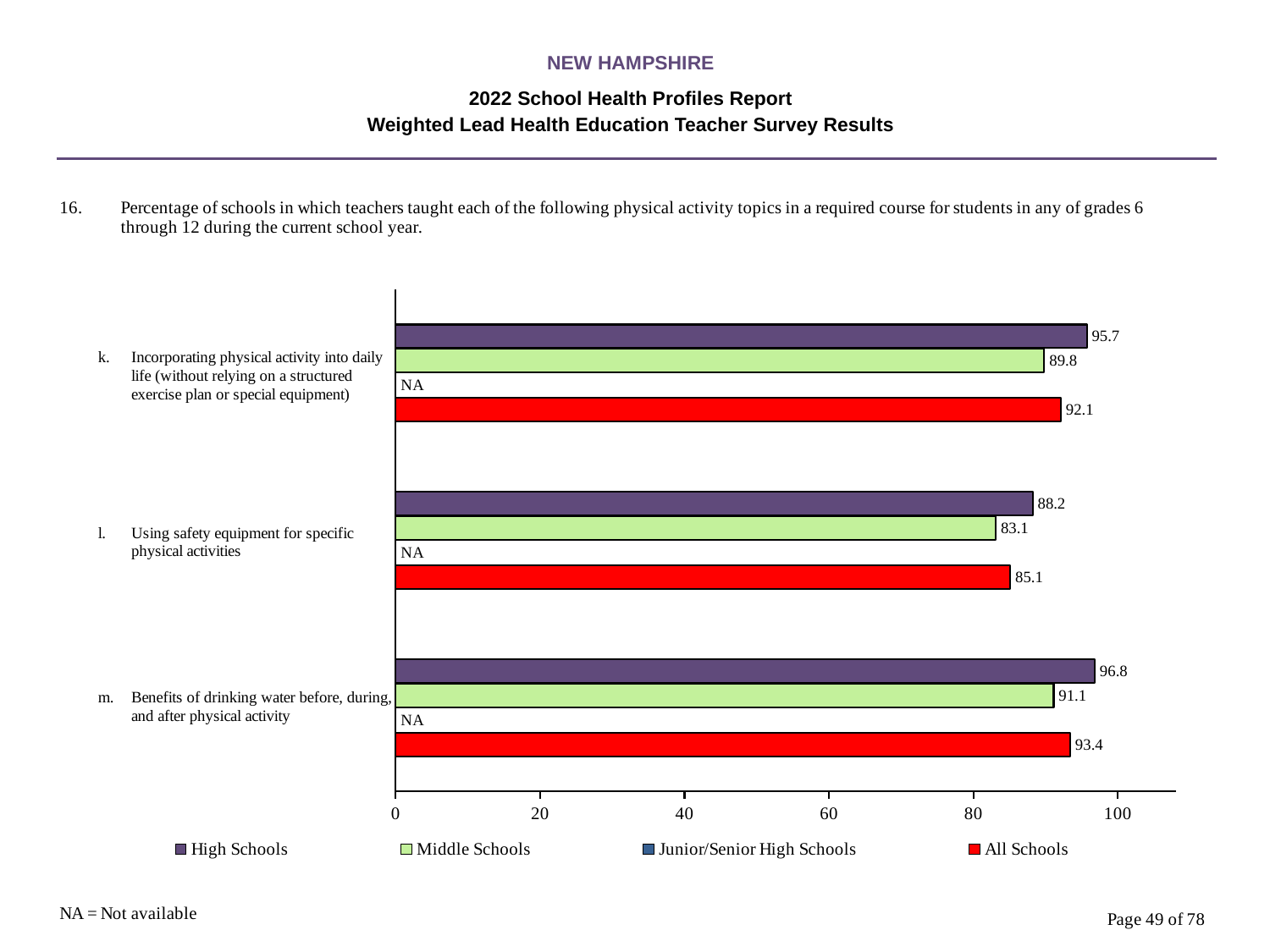
How many series does the legend list? 4 Which is larger for topic l, using safety equipment: the High Schools value or the All Schools value? High Schools Which topic has the highest value for High Schools? m. Benefits of drinking water before, during, and after physical activity Is the All Schools value for topic l, using safety equipment, greater or less than 80? greater What is the difference between the High Schools and Middle Schools values for topic k, incorporating physical activity into daily life? 5.9 What is the value for High Schools for topic m, benefits of drinking water before, during, and after physical activity? 96.8 What is the value for All Schools for topic k, incorporating physical activity into daily life? 92.1 Which topic has the lowest value for Middle Schools? l. Using safety equipment for specific physical activities How many topics are shown on the chart? 3 What is the value for Middle Schools for topic l, using safety equipment for specific physical activities? 83.1 What kind of chart is shown on the slide? Bar chart What is shown for Junior/Senior High Schools for topic l, using safety equipment for specific physical activities? NA